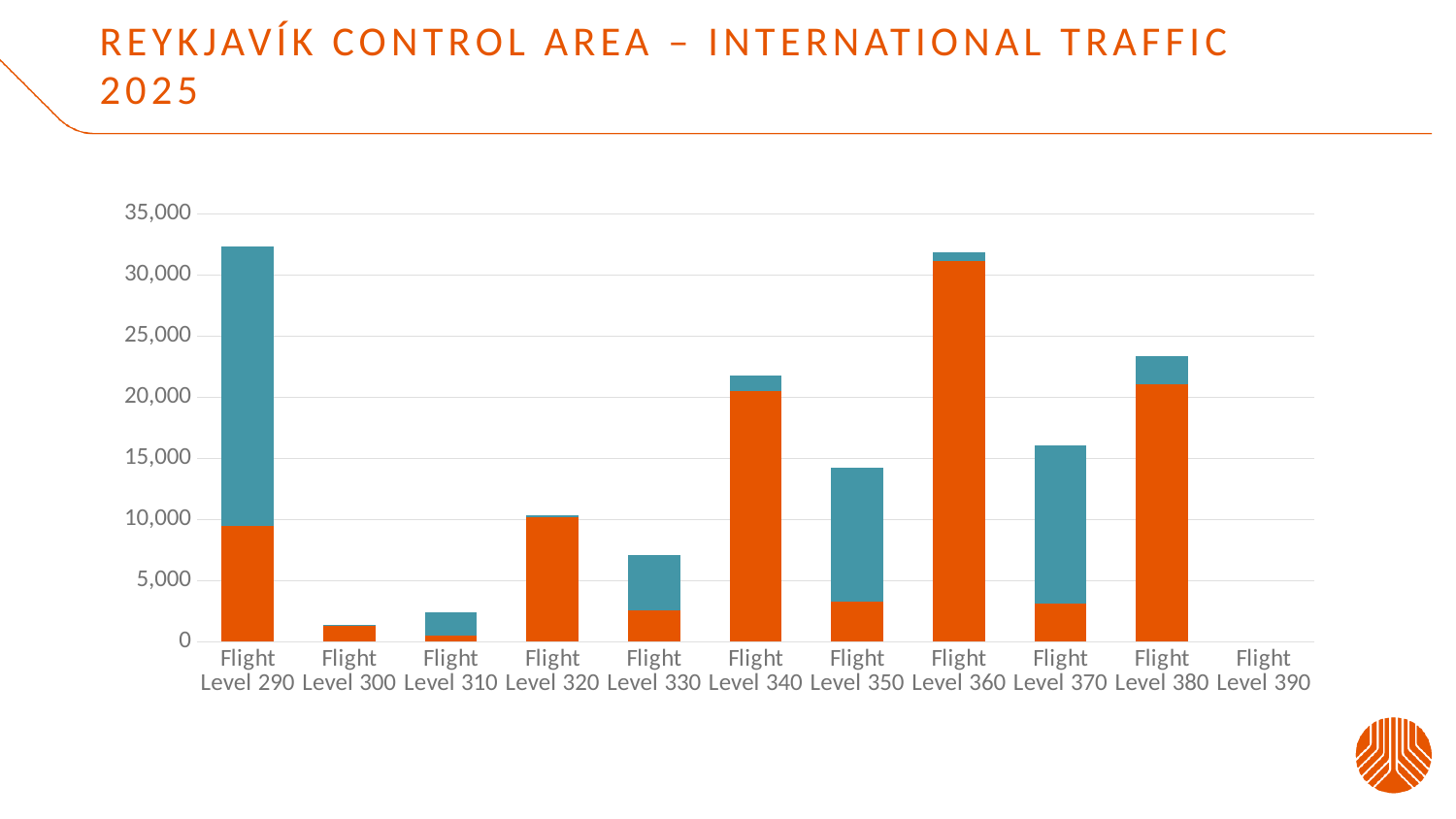
Is the total value for Flight Level 300 greater or less than 5,000? less What two colours are used for the stacked segments in the bars? Orange and teal What kind of chart is shown on the slide? Stacked bar chart Which has the larger total bar, Flight Level 330 or Flight Level 350? Flight Level 350 What is the title of the slide containing the chart? Reykjavík Control Area – International Traffic 2025 Is the total value for Flight Level 350 greater or less than 15,000? less Is the total value for Flight Level 290 greater or less than 30,000? greater How many flight level categories are shown on the x axis? 11 Which has the larger total bar, Flight Level 370 or Flight Level 380? Flight Level 380